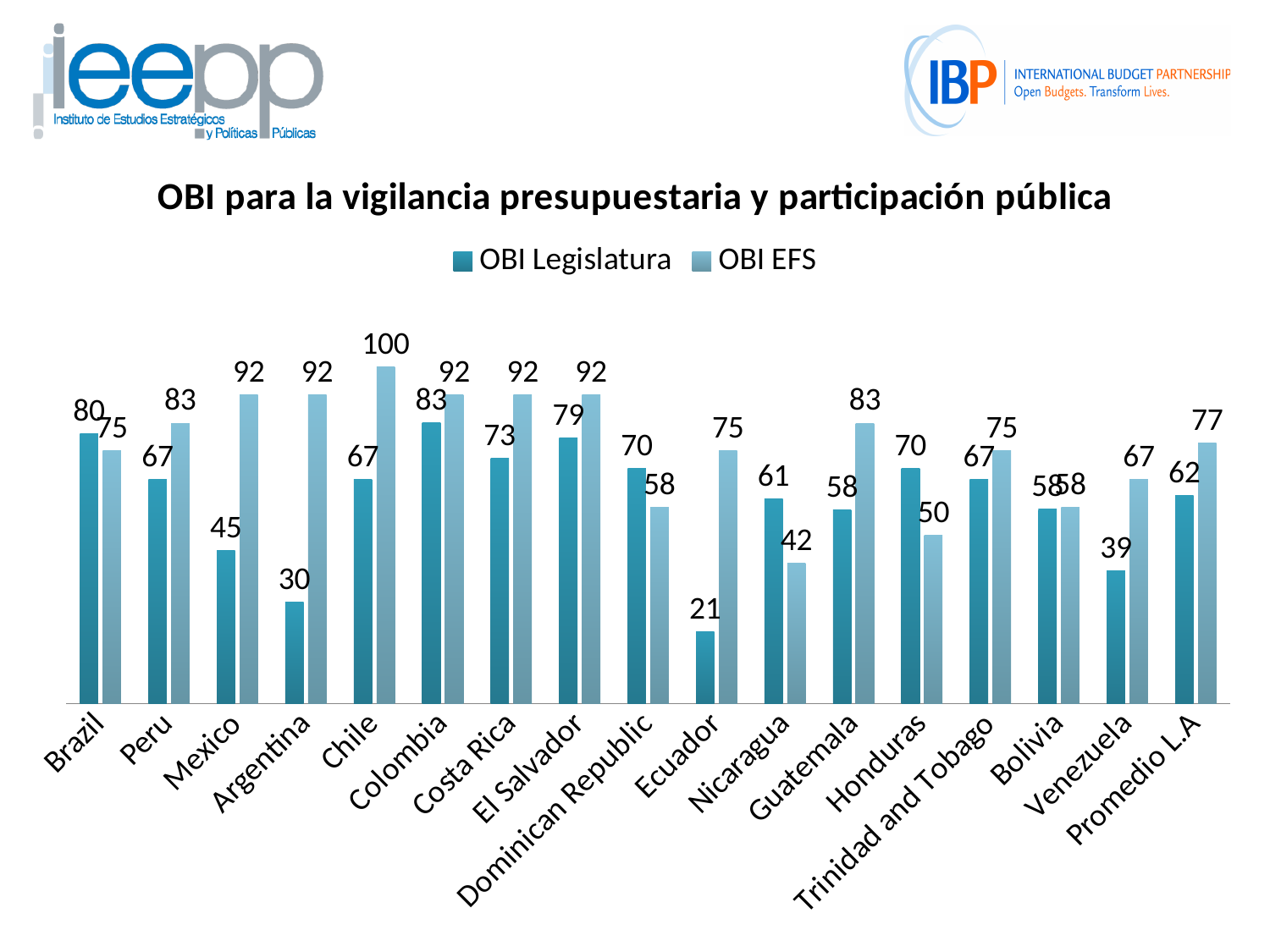
What is the OBI EFS value for Promedio L.A? 77 What is the OBI Legislatura value for Ecuador? 21 What type of chart is shown on the slide? Bar chart How many categories are shown on the x axis? 17 Which country has the lowest OBI EFS value? Nicaragua For Brazil, how much higher is OBI Legislatura than OBI EFS? 5 What is the OBI EFS value for Chile? 100 For Argentina, what is the difference between the OBI EFS value and the OBI Legislatura value? 62 For Dominican Republic, which is larger: OBI Legislatura or OBI EFS? OBI Legislatura How many series does the legend list? 2 Which country has the lowest OBI Legislatura value? Ecuador Which country has the highest OBI Legislatura value? Colombia